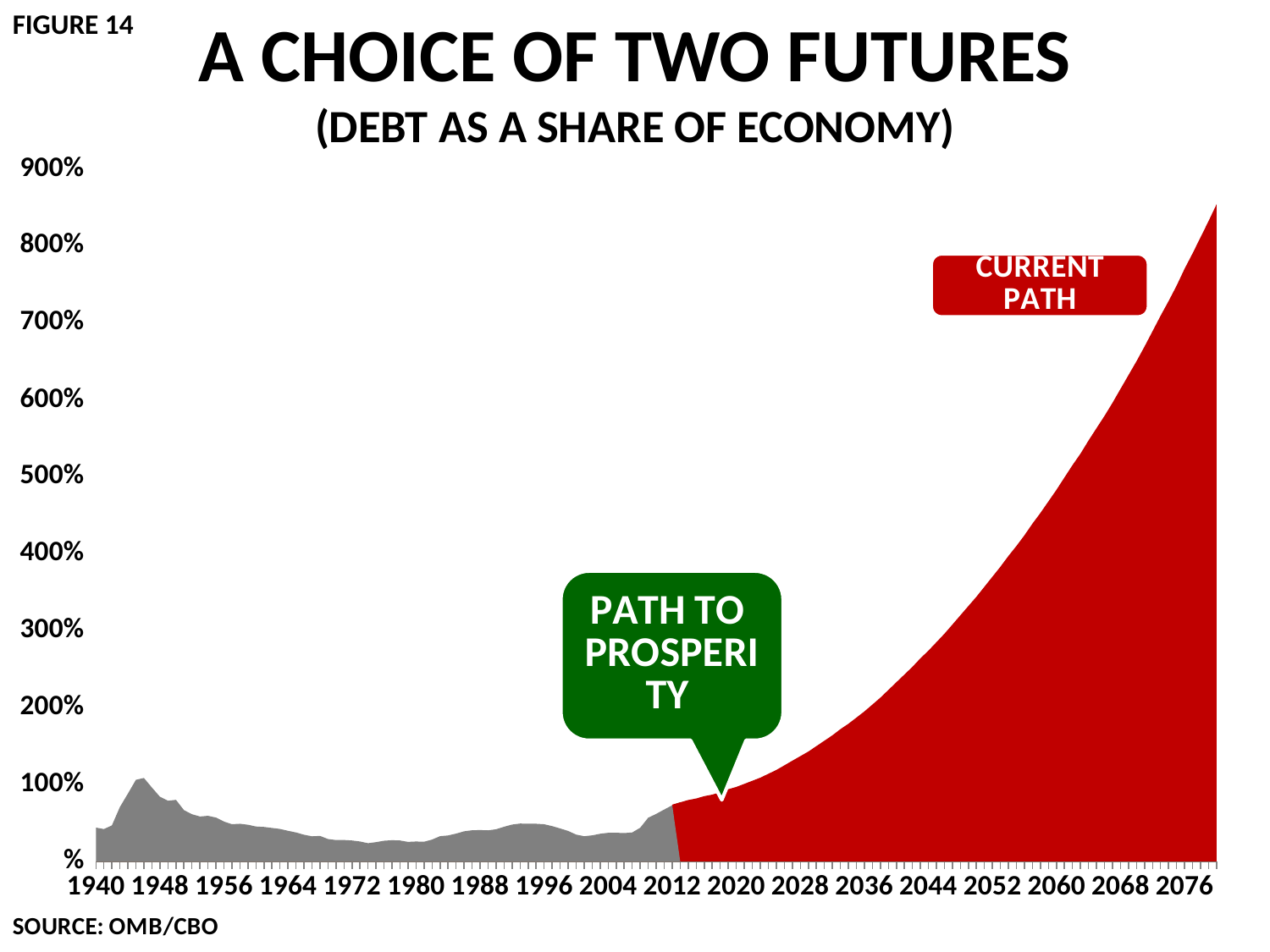
Is the value for 2012 greater or less than 100%? less Do the values rise or fall along the x axis from 2012 to 2076? rise What kind of chart is shown on the slide? Area chart Is the value for 1948 greater or less than 200%? less Which year on the x axis has the highest value? 2076 How many year labels are shown on the x axis? 18 Is the value for 2068 greater or less than 500%? greater What does the subtitle say the chart measures? Debt as a share of economy What is the title of the chart? A CHOICE OF TWO FUTURES Do the values rise or fall along the x axis from 1948 to 1980? fall